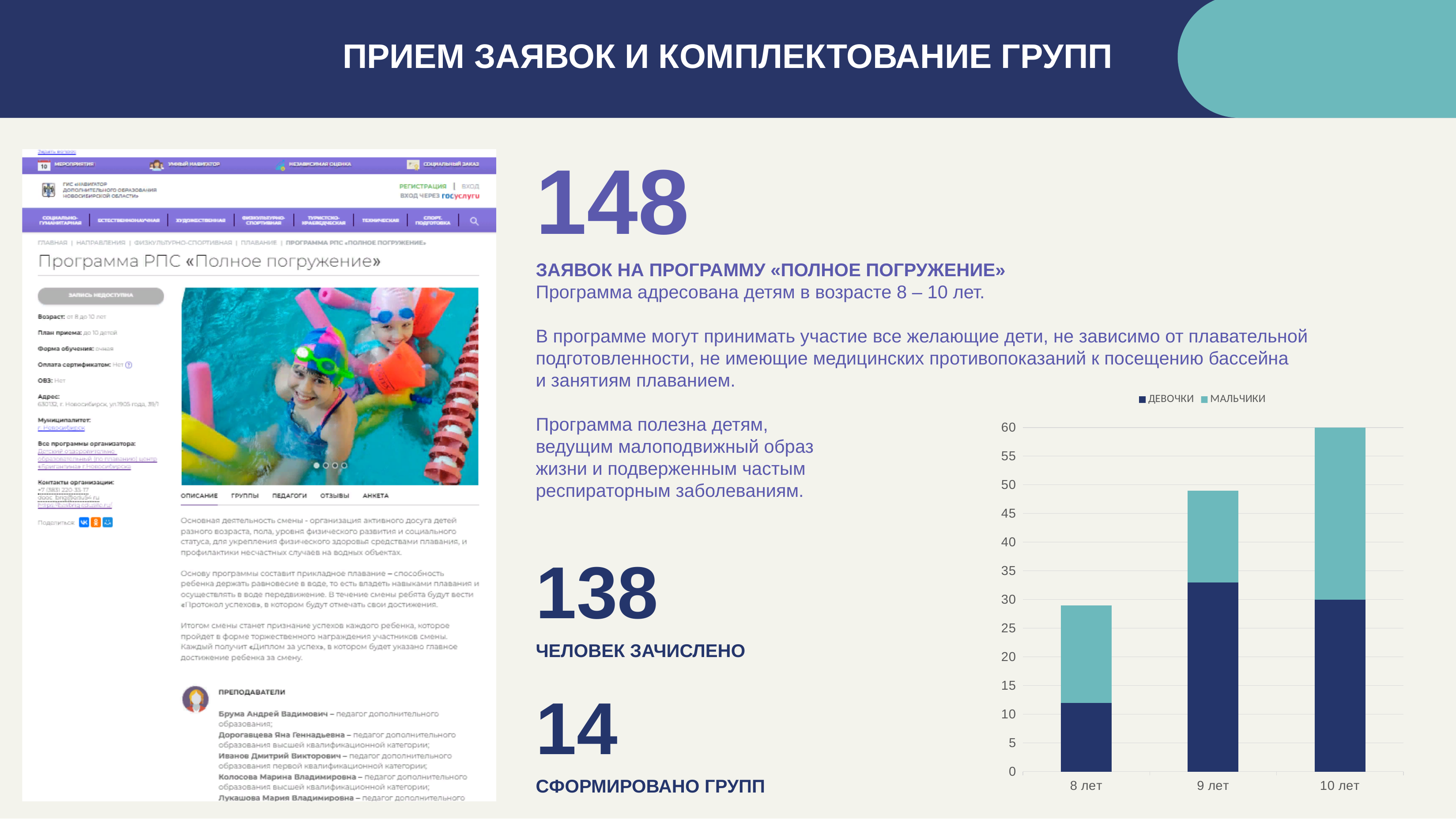
Is the total stacked value for 10 лет greater or less than 55? greater Which colour represents the ДЕВОЧКИ series in the chart? Dark blue How many series does the chart legend list? 2 Is the ДЕВОЧКИ value for 8 лет greater or less than 15? less Which age category has the shortest stacked bar in the chart? 8 лет Which has a larger ДЕВОЧКИ value: 8 лет or 9 лет? 9 лет Is the ДЕВОЧКИ value for 9 лет greater or less than 30? greater How many age categories are shown on the x axis of the chart? 3 What are the two series named in the chart legend? ДЕВОЧКИ and МАЛЬЧИКИ What kind of chart is shown on the right of the slide? Stacked bar chart Which age category has the tallest stacked bar in the chart? 10 лет